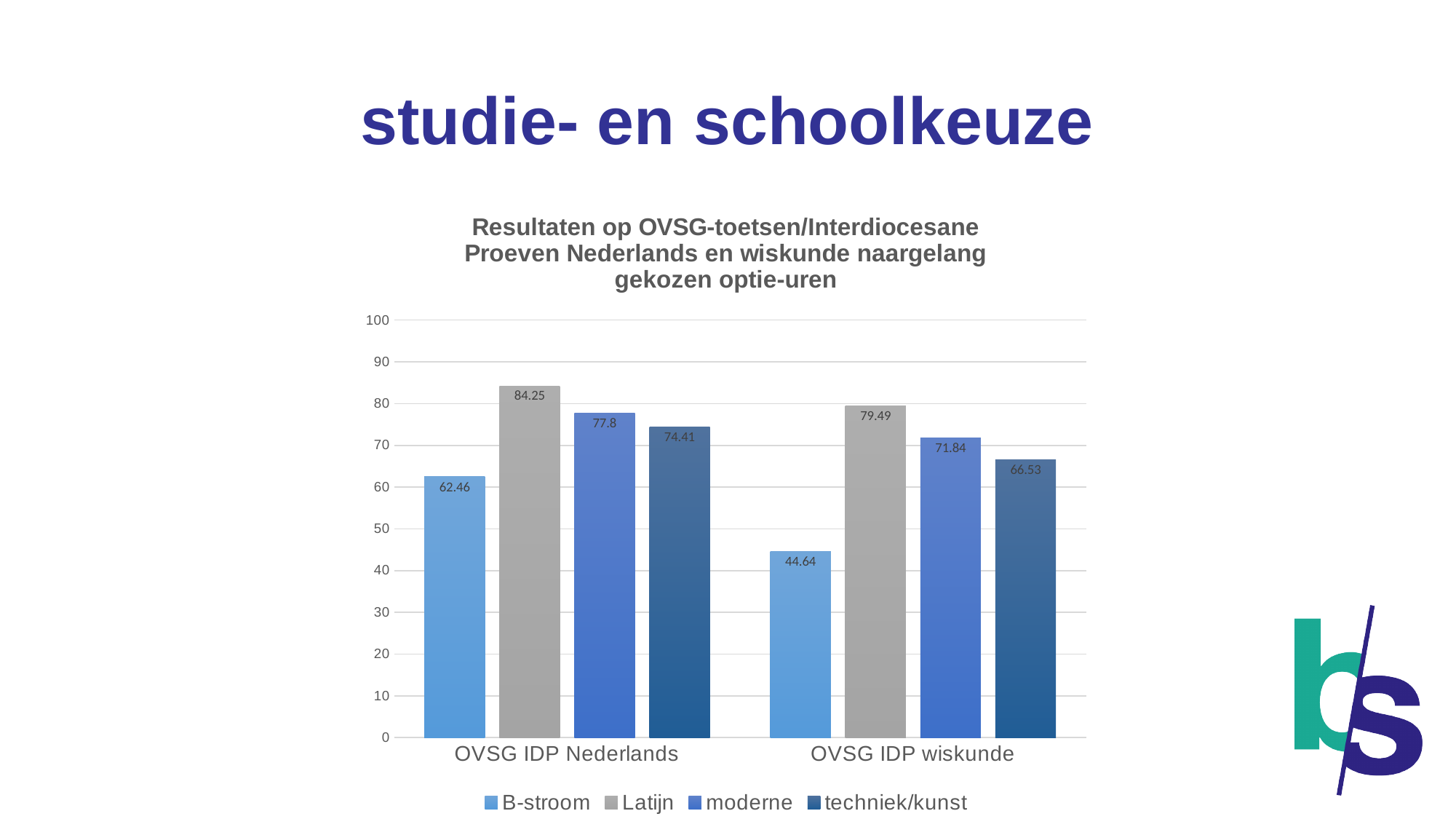
Which series has the highest value in OVSG IDP wiskunde? Latijn Is the value for techniek/kunst in OVSG IDP wiskunde greater or less than 70? less Which series has the lowest value in OVSG IDP Nederlands? B-stroom What is the value for B-stroom in OVSG IDP wiskunde? 44.64 What is the value for techniek/kunst in OVSG IDP Nederlands? 74.41 What kind of chart is shown on the slide? bar chart How many categories are shown on the x axis? 2 Which is larger: moderne in OVSG IDP Nederlands or moderne in OVSG IDP wiskunde? moderne in OVSG IDP Nederlands How many series does the legend list? 4 What is the value for Latijn in OVSG IDP Nederlands? 84.25 What is the difference between the Latijn and B-stroom values in OVSG IDP wiskunde? 34.85 What is the value for moderne in OVSG IDP wiskunde? 71.84